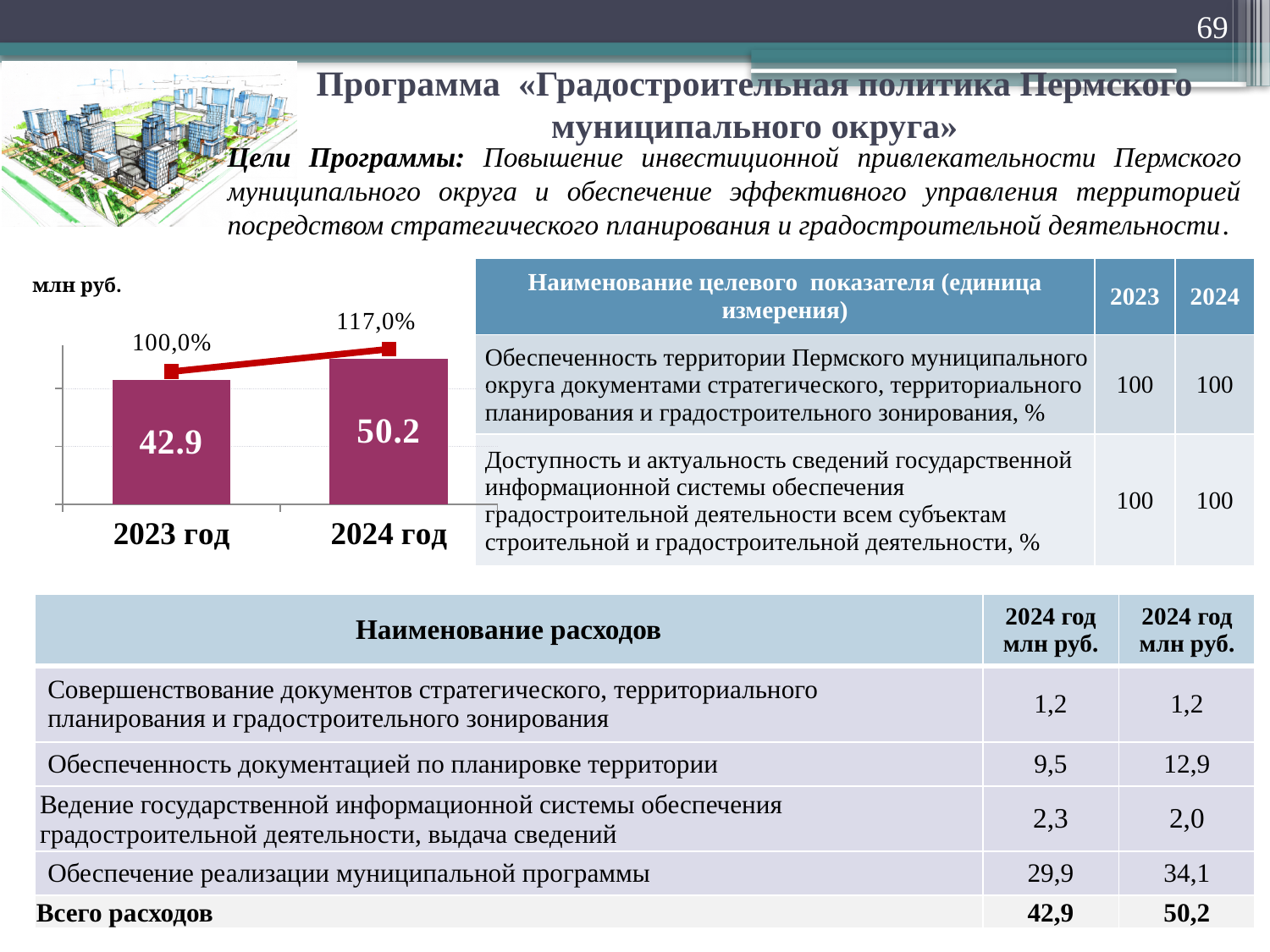
What is the difference between the 2024 год and 2023 год bar values? 7.3 Do the bar values rise or fall from 2023 год to 2024 год? rise Which year has the higher bar in the chart? 2024 год Is the bar value for 2024 год larger or smaller than the bar value for 2023 год? larger What kind of chart is shown on the slide? combination bar and line chart What is the value for 2024 год in the bar chart? 50.2 What is the value for 2023 год in the bar chart? 42.9 How many categories are shown on the x axis of the chart? 2 What unit is indicated above the chart? млн руб. What percentage label is shown on the line for 2024 год? 117,0% What percentage label is shown on the line for 2023 год? 100,0% Which year has the lower bar in the chart? 2023 год